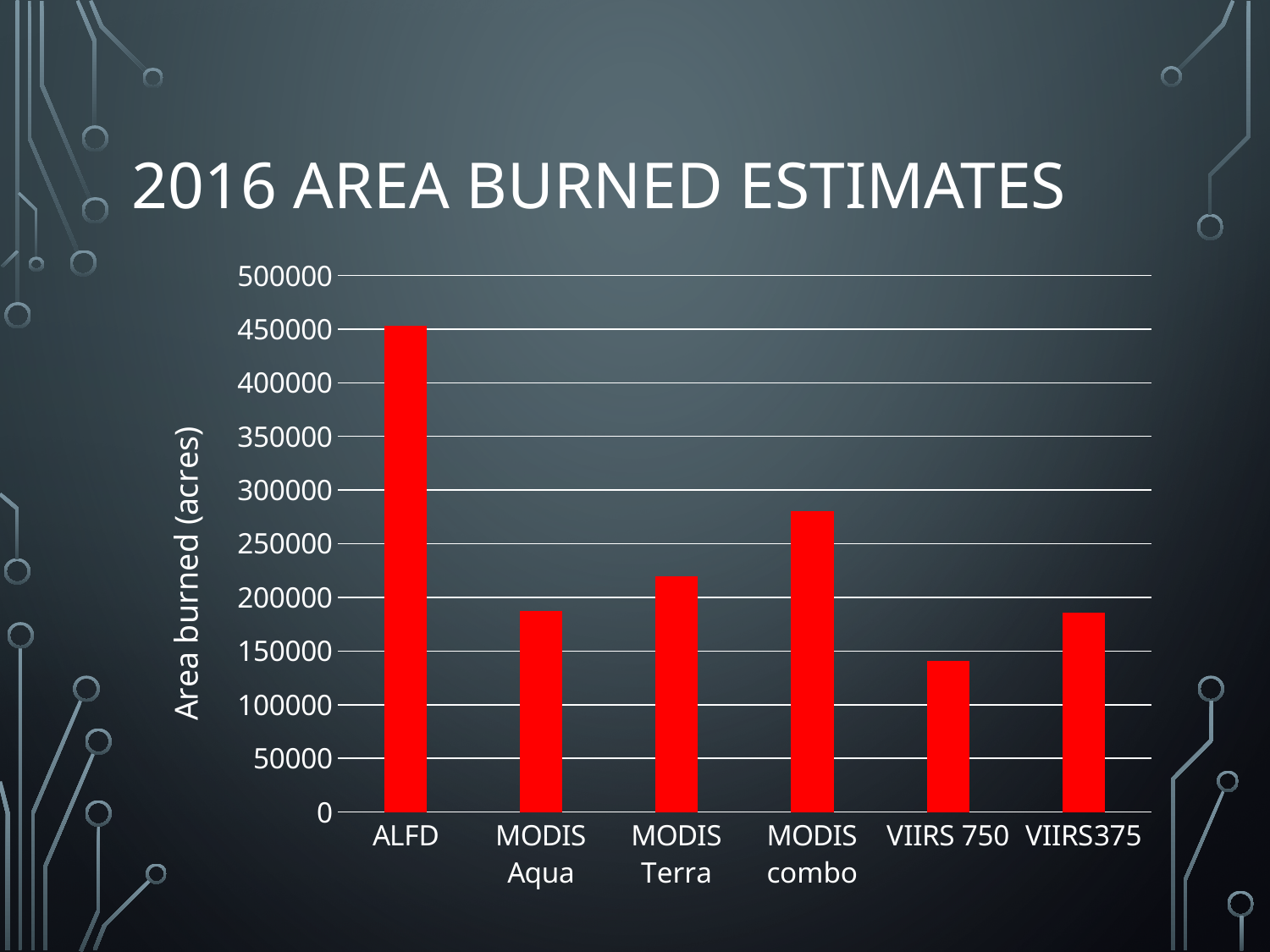
What is the label of the vertical axis? Area burned (acres) What kind of chart is shown on the slide? bar chart Is the value for MODIS Aqua greater or less than 200000? less Is the value for ALFD greater or less than 400000? greater Which category has the lowest area burned estimate? VIIRS 750 Which has a larger area burned estimate, MODIS combo or MODIS Terra? MODIS combo Is the value for MODIS Terra greater or less than 200000? greater How many categories are shown on the x axis of the chart? 6 What is the title of the slide? 2016 AREA BURNED ESTIMATES Which category has the highest area burned estimate? ALFD